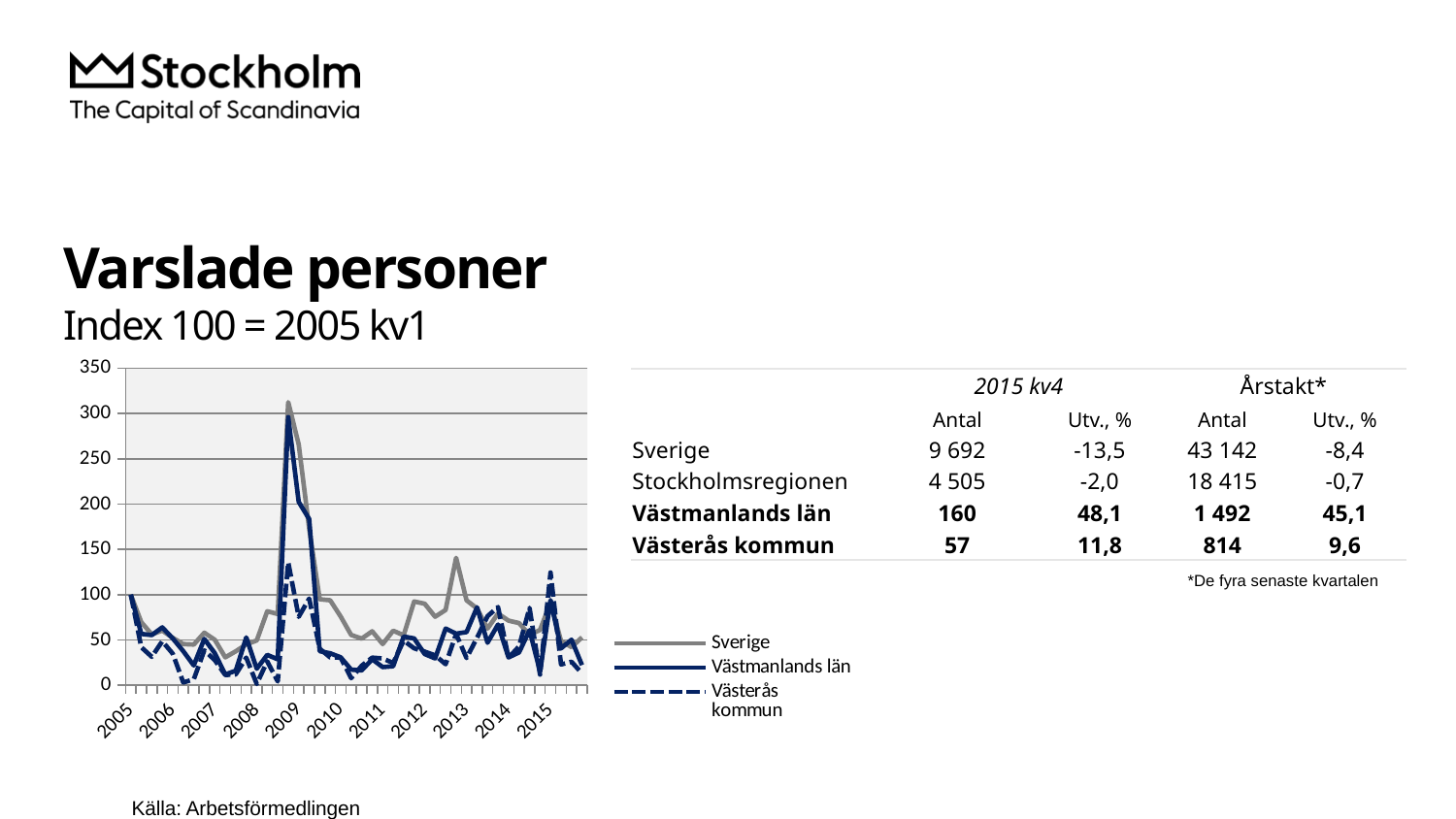
What is the index base period for the chart, according to the subtitle? 2005 kv1 = 100 Is the peak value of the Sverige series around 2009 greater or less than 250? greater Is the peak value of the Västerås kommun series around 2009 greater or less than 200? less Is the Sverige series' local peak around 2013 greater or less than 100? greater What kind of chart is shown on the slide? line chart Which series are listed in the chart's legend? Sverige, Västmanlands län, Västerås kommun What is the highest tick value shown on the chart's vertical axis? 350 How many series does the chart's legend list? 3 Does the Sverige series rise or fall from its 2009 peak to 2010? fall At the 2009 peak, which series is higher, Sverige or Västerås kommun? Sverige What is the value of all series at the start of the chart (2005 kv1)? 100